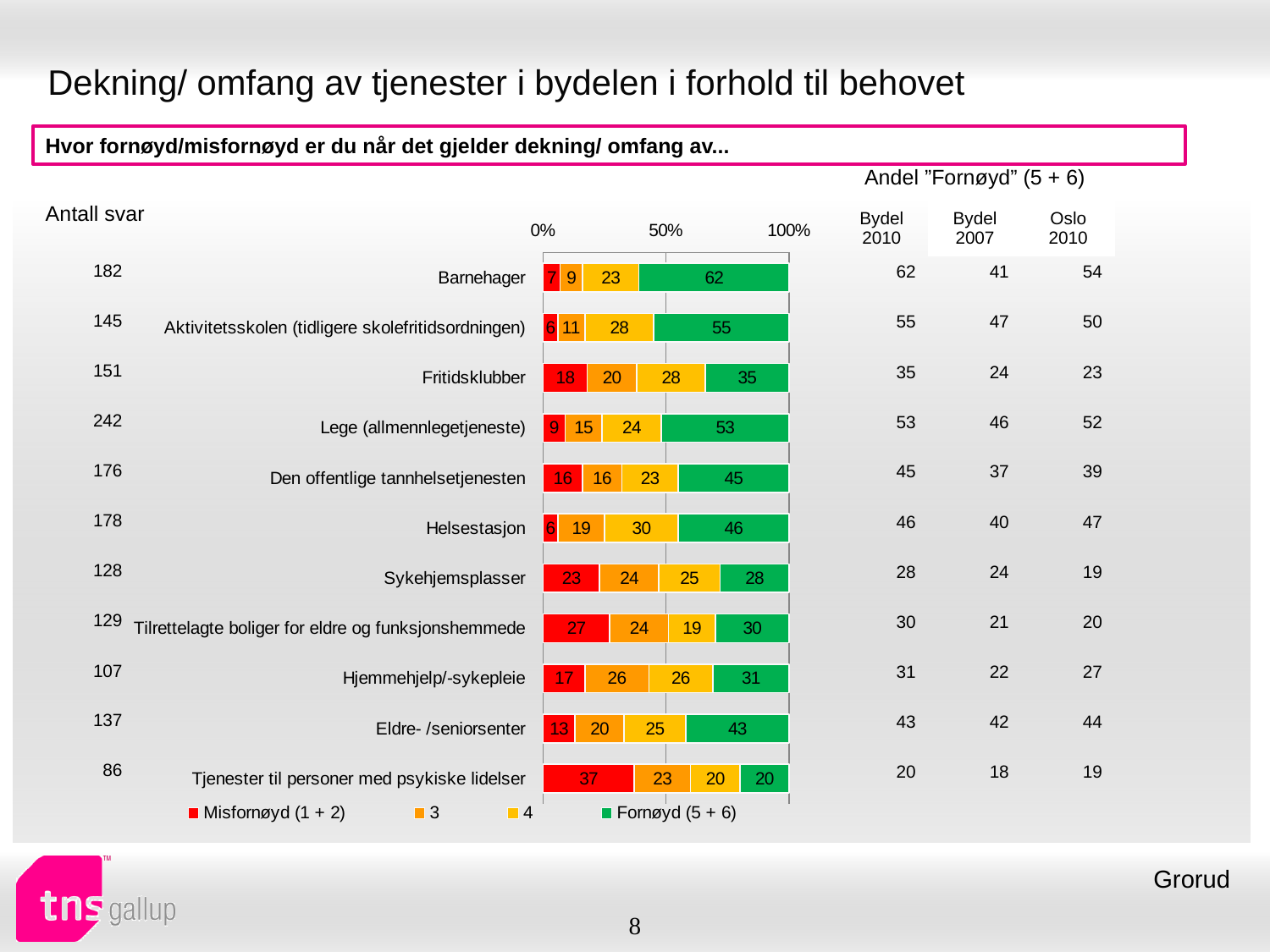
What is the Fornøyd (5 + 6) value for Barnehager? 62 What is the value of the '4' segment for Helsestasjon? 30 What type of chart is shown on the slide? Stacked bar chart What is the difference between the Fornøyd (5 + 6) values for Barnehager and Fritidsklubber? 27 How many service categories are plotted in the chart? 11 Which category has the highest Fornøyd (5 + 6) value? Barnehager Which category has the lowest Fornøyd (5 + 6) value? Tjenester til personer med psykiske lidelser Which has a larger Fornøyd (5 + 6) value, Lege (allmennlegetjeneste) or Helsestasjon? Lege (allmennlegetjeneste) Which category has the highest Misfornøyd (1 + 2) value? Tjenester til personer med psykiske lidelser What is the Misfornøyd (1 + 2) value for Sykehjemsplasser? 23 What is the total of the stacked bar for Sykehjemsplasser? 100 How many series does the chart legend list? 4